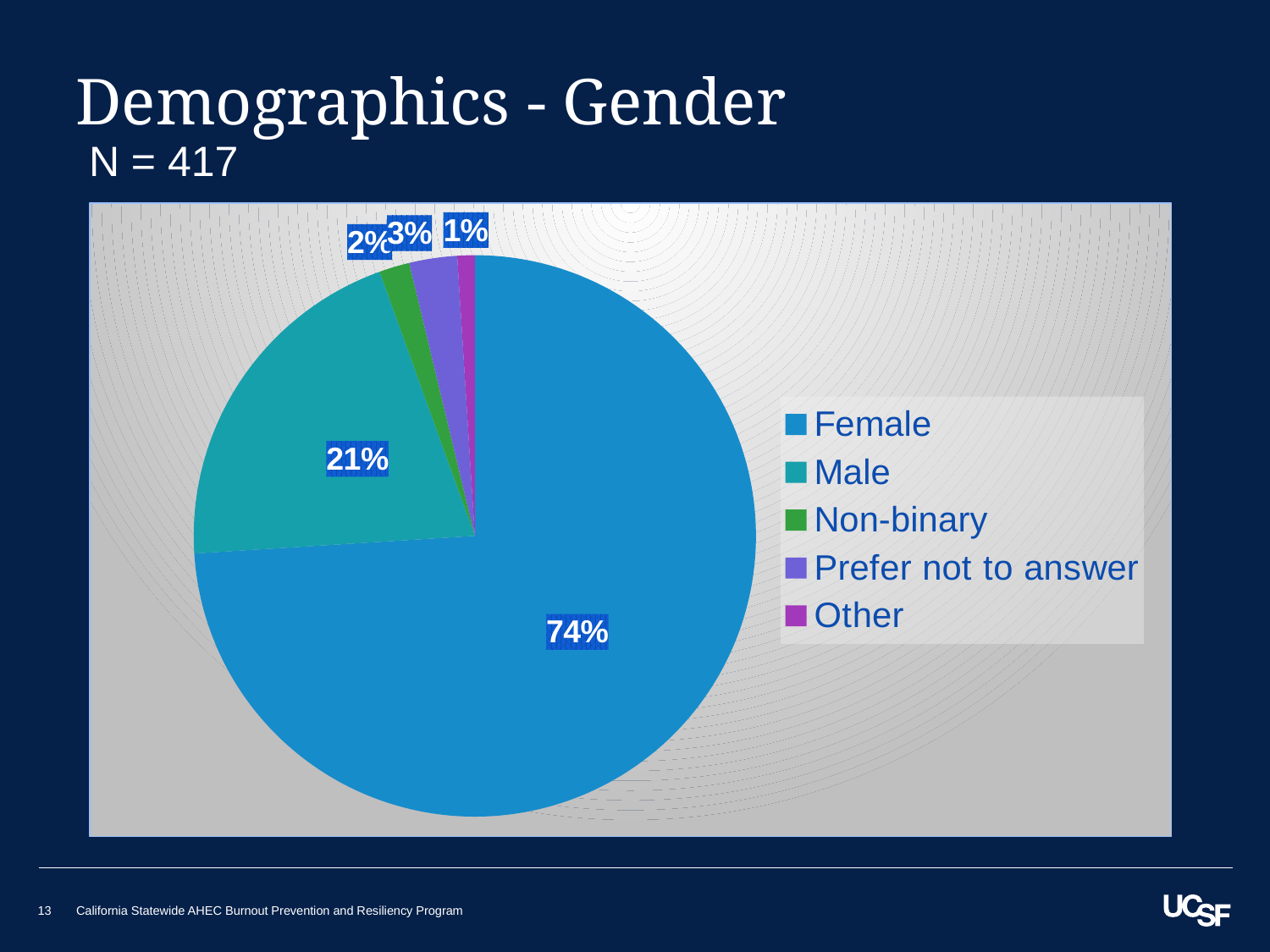
What is the difference in percentage points between the Female and Male shares? 53 What percentage of respondents are in the Other category? 1% What kind of chart is shown on the slide? Pie chart What percentage of respondents chose Prefer not to answer? 3% Which is larger, the Non-binary share or the Prefer not to answer share? Prefer not to answer What percentage of respondents are Male? 21% Which gender category has the smallest share of the pie? Other What percentage of respondents are Female? 74% What is the sample size (N) stated on the slide? 417 Which gender category has the largest share of the pie? Female What percentage of respondents are Non-binary? 2% How many categories does the legend list? 5